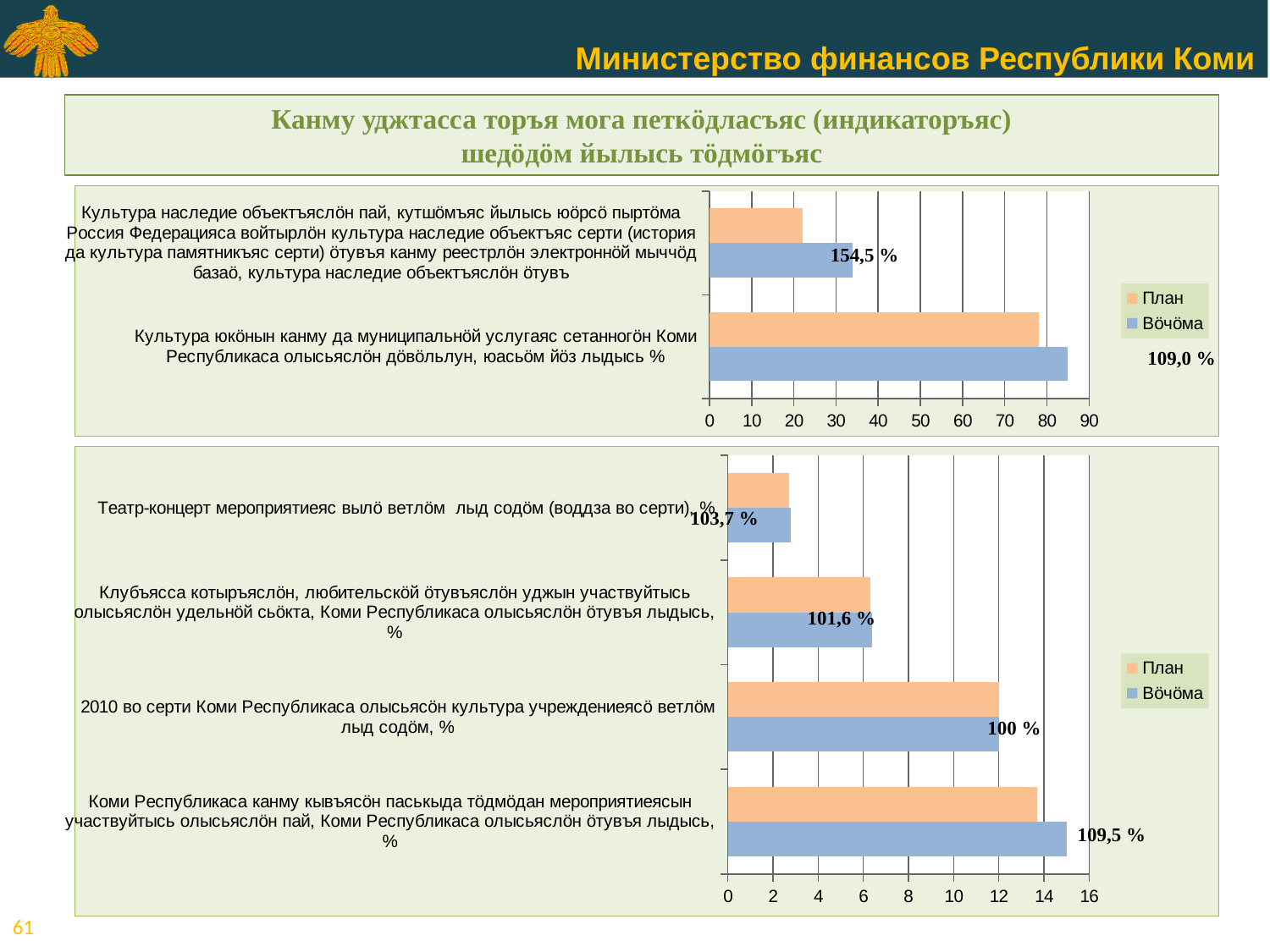
In the top chart, is the Вöчöма value for 'Культура юкöнын канму да муниципальнöй услугаяс сетанногöн Коми Республикаса олысьяслöн дöвöльлун, юасьöм йöз лыдысь %' greater or less than 80? greater In the top chart, for the first (upper) category, which series has the larger value, План or Вöчöма? Вöчöма In the top chart, is the План value for the first (upper) category greater or less than 30? less In the bottom chart, what percentage label is printed next to the bars for 'Театр-концерт мероприятиеяс вылö ветлöм лыд содöм (воддза во серти), %'? 103,7 % In the bottom chart, which category has the longest Вöчöма bar? Коми Республикаса канму кывъясöн паськыда тöдмöдан мероприятиеясын участвуйтысь олысьяслöн пай, Коми Республикаса олысьяслöн öтувъя лыдысь, % How many categories are shown in the top chart? 2 In the bottom chart, which category has the shortest План bar? Театр-концерт мероприятиеяс вылö ветлöм лыд содöм (воддза во серти), % How many series does the legend of the bottom chart list? 2 What kind of chart is the top chart on the slide? bar chart In the bottom chart, what percentage label is printed next to the bars for '2010 во серти Коми Республикаса олысьясöн культура учреждениеясö ветлöм лыд содöм, %'? 100 % How many categories are shown in the bottom chart? 4 In the top chart, what percentage label is printed next to the bars for 'Культура юкöнын канму да муниципальнöй услугаяс сетанногöн Коми Республикаса олысьяслöн дöвöльлун, юасьöм йöз лыдысь %'? 109,0 %